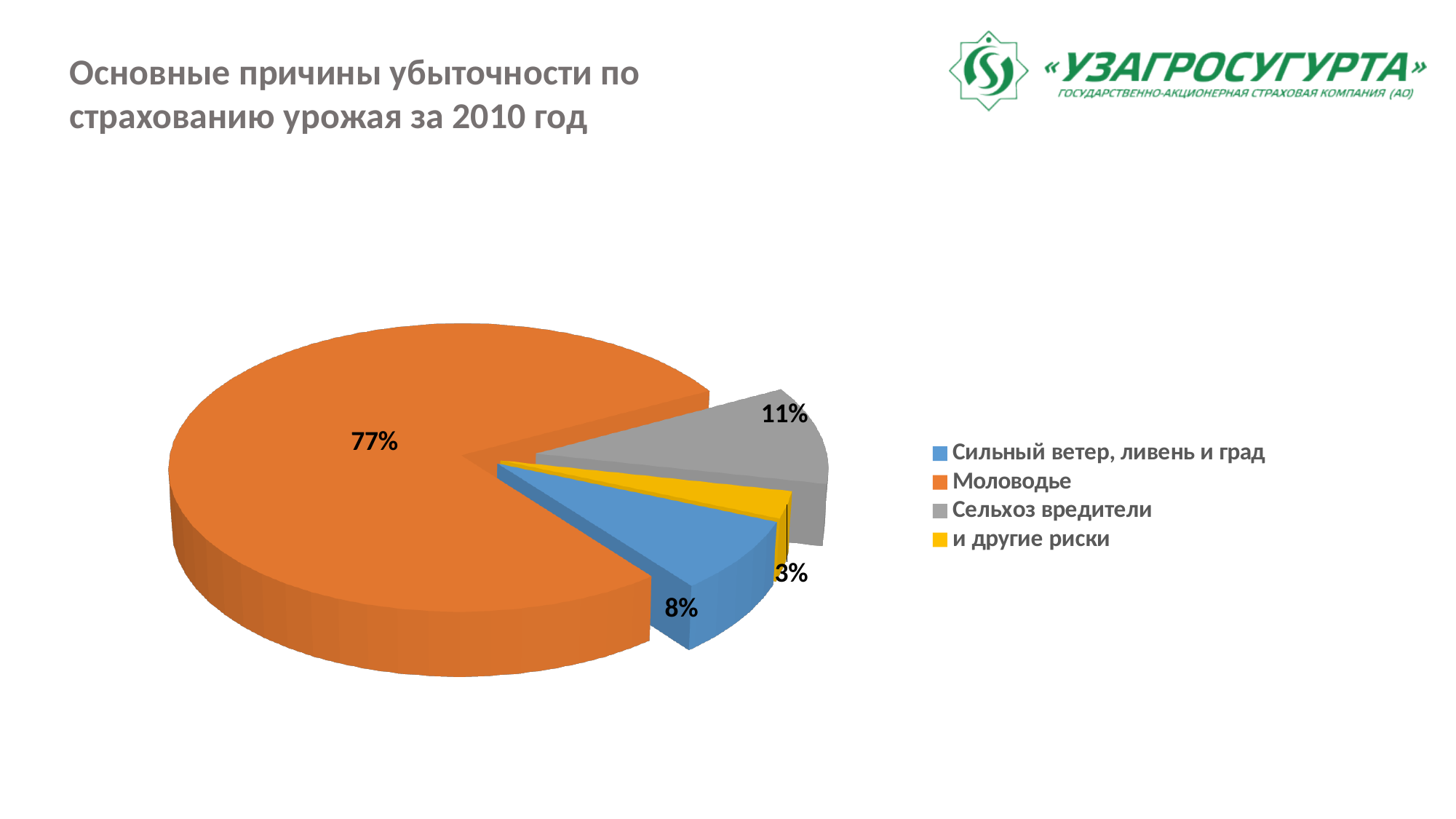
What share of the pie does Сильный ветер, ливень и град account for? 8% What share of the pie does и другие риски account for? 3% What share of the pie does Моловодье account for? 77% Which category has the smallest slice of the pie? и другие риски Which category has the largest slice of the pie? Моловодье What is the difference in percentage points between Моловодье and Сельхоз вредители? 66 What kind of chart is shown on the slide? Pie chart How many categories does the pie chart show? 4 Which is larger: the share for Сельхоз вредители or the share for Сильный ветер, ливень и град? Сельхоз вредители What colour is the slice for Сельхоз вредители? Gray What is the title of the slide containing the chart? Основные причины убыточности по страхованию урожая за 2010 год